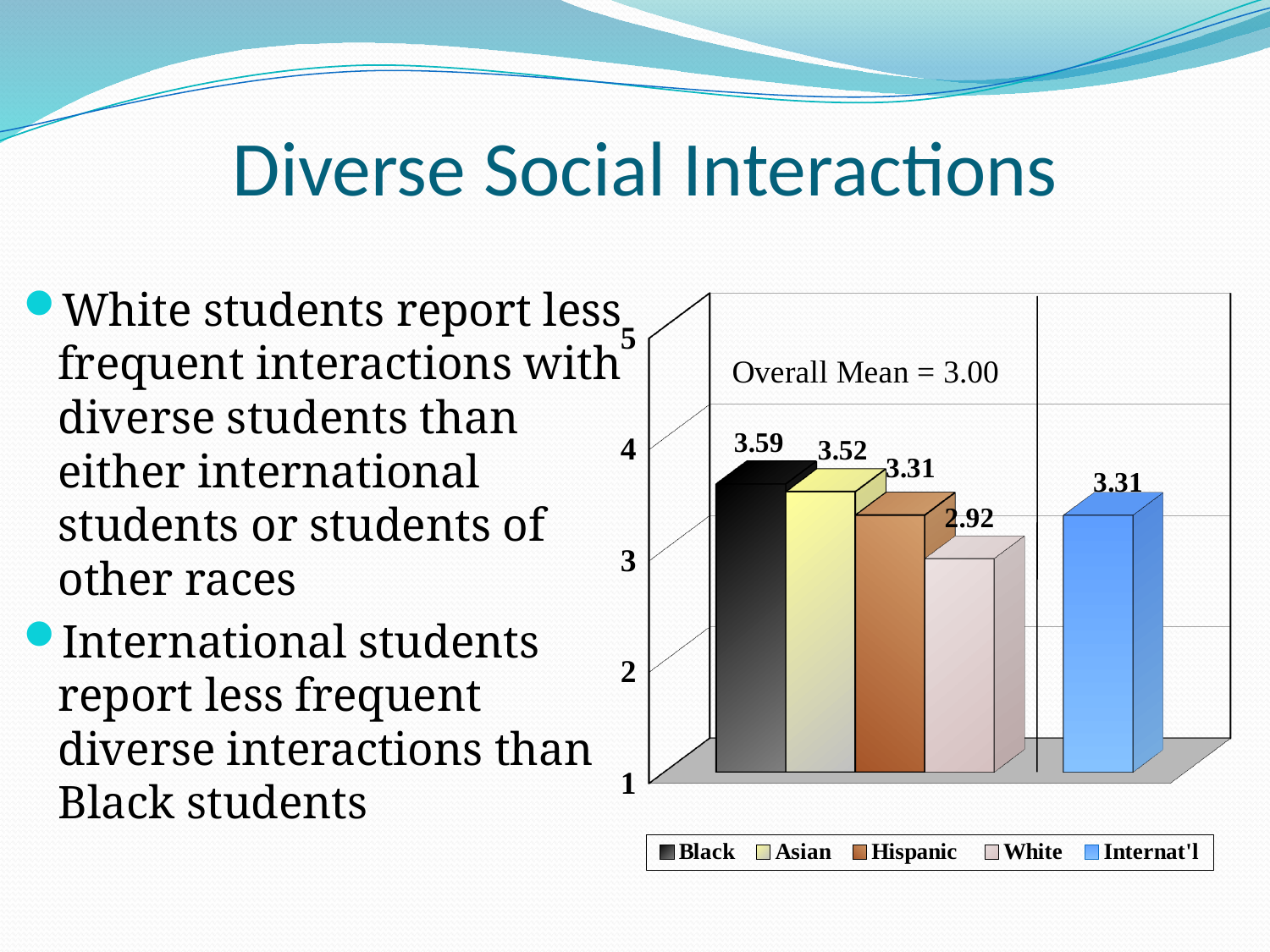
How many bars are plotted in the chart? 5 What is the difference between the values for Black and White students? 0.67 What is the value for White students in the chart? 2.92 Which group has the highest value in the chart? Black What overall mean is stated on the chart? 3.00 Is the value for White students greater or less than 3? less What kind of chart is shown on the slide? bar chart What is the value for Internat'l students in the chart? 3.31 What is the difference between the values for Asian and Hispanic students? 0.21 Which group has the lowest value in the chart? White Which is larger, the value for Asian students or the value for White students? Asian What is the value for Black students in the chart? 3.59